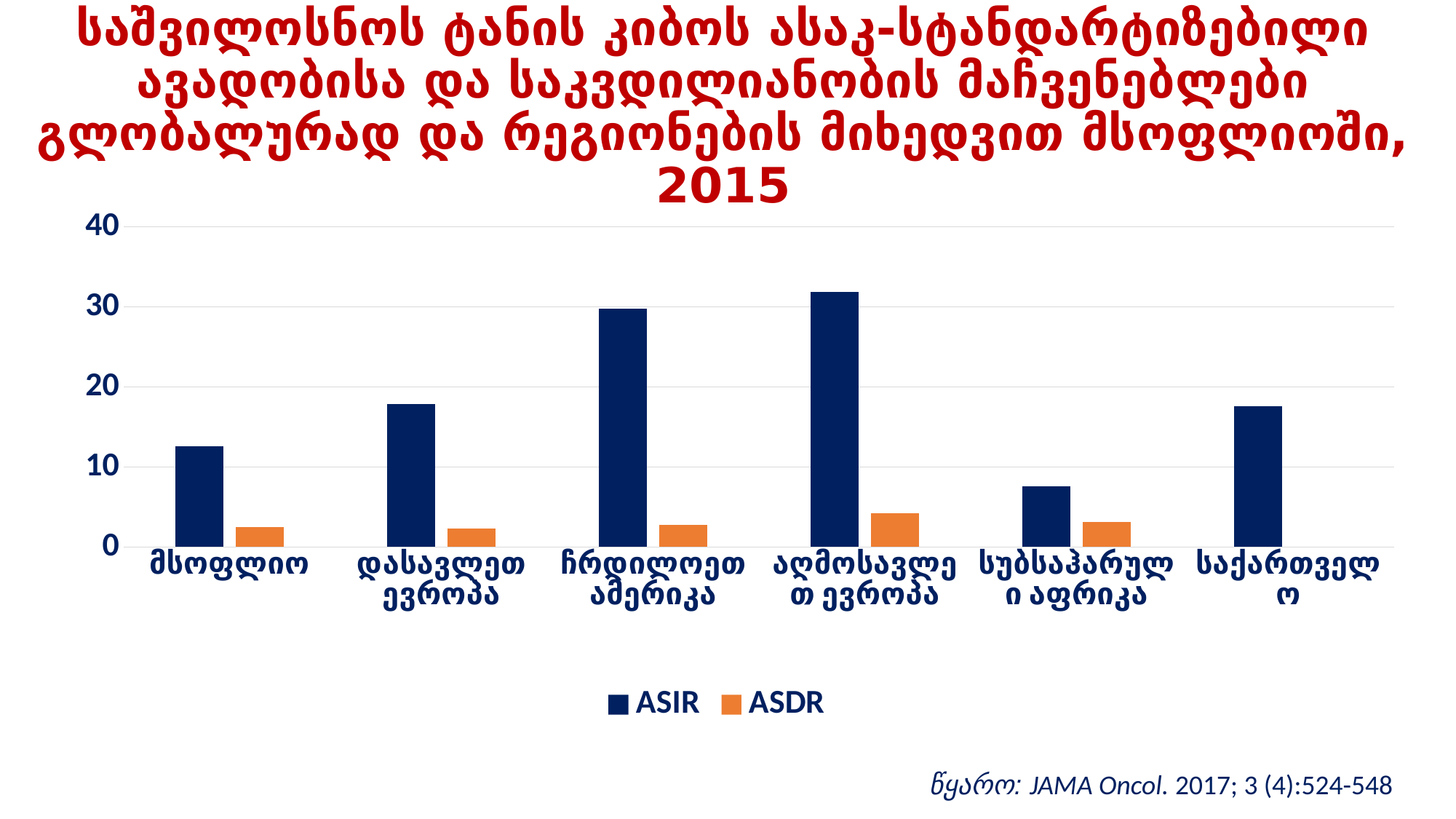
Is the ASIR value for აღმოსავლეთ ევროპა greater or less than 30? greater Which category has the highest ASIR value? აღმოსავლეთ ევროპა Which is larger, the ASIR value for ჩრდილოეთ ამერიკა or for აღმოსავლეთ ევროპა? აღმოსავლეთ ევროპა How many series does the legend list? 2 What are the two series names listed in the legend? ASIR and ASDR Is the ASIR value for ჩრდილოეთ ამერიკა greater or less than 20? greater Which category has the lowest ASIR value? სუბსაჰარული აფრიკა How many categories are shown on the x axis? 6 Which is larger, the ASIR value for მსოფლიო or for დასავლეთ ევროპა? დასავლეთ ევროპა Is the ASIR value for სუბსაჰარული აფრიკა greater or less than 10? less What kind of chart is shown on the slide? bar chart Which category has the highest ASDR value? აღმოსავლეთ ევროპა